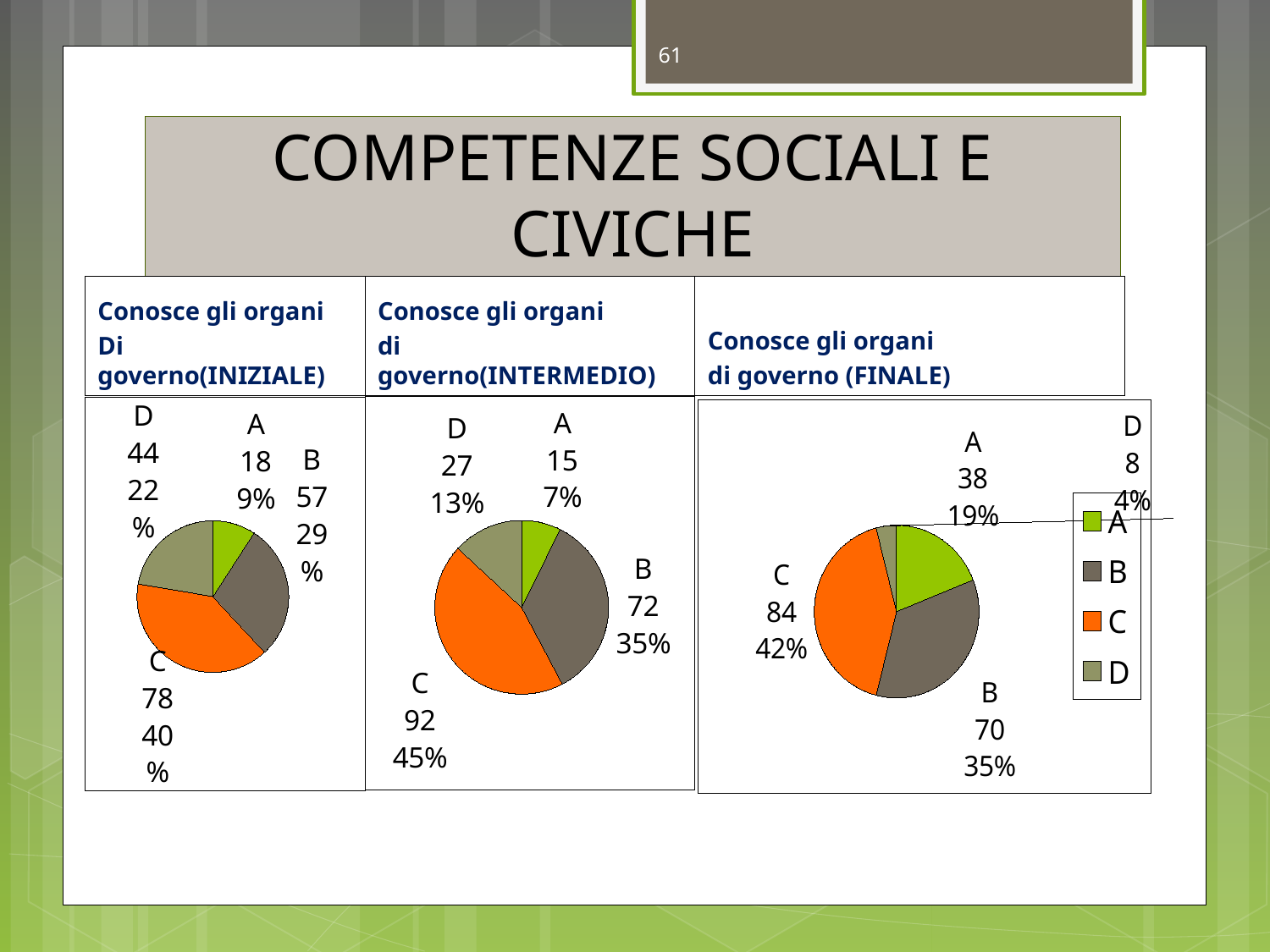
In the 'Conosce gli organi di governo (FINALE)' pie chart, which is larger, the value for B or the value for C? C In the 'Conosce gli organi di governo (FINALE)' chart, which colour does the legend assign to category C? Orange How many categories does the 'Conosce gli organi di governo (FINALE)' pie chart show? 4 In the 'Conosce gli organi di governo (INTERMEDIO)' pie chart, what is the difference between the values for C and D? 65 In the 'Conosce gli organi di governo (FINALE)' pie chart, what is the value for category D? 8 In the 'Conosce gli organi di governo (INIZIALE)' pie chart, which category has the smallest value? A In the 'Conosce gli organi di governo (INIZIALE)' pie chart, what is the value for category C? 78 In the 'Conosce gli organi di governo (INTERMEDIO)' pie chart, which category has the largest value? C In the 'Conosce gli organi di governo (INTERMEDIO)' pie chart, what is the value for category B? 72 What type of chart is used for 'Conosce gli organi di governo (INIZIALE)'? Pie chart In the 'Conosce gli organi di governo (FINALE)' pie chart, what share of the pie does category A have? 19% In the 'Conosce gli organi di governo (INIZIALE)' pie chart, what share of the pie does category D have? 22%